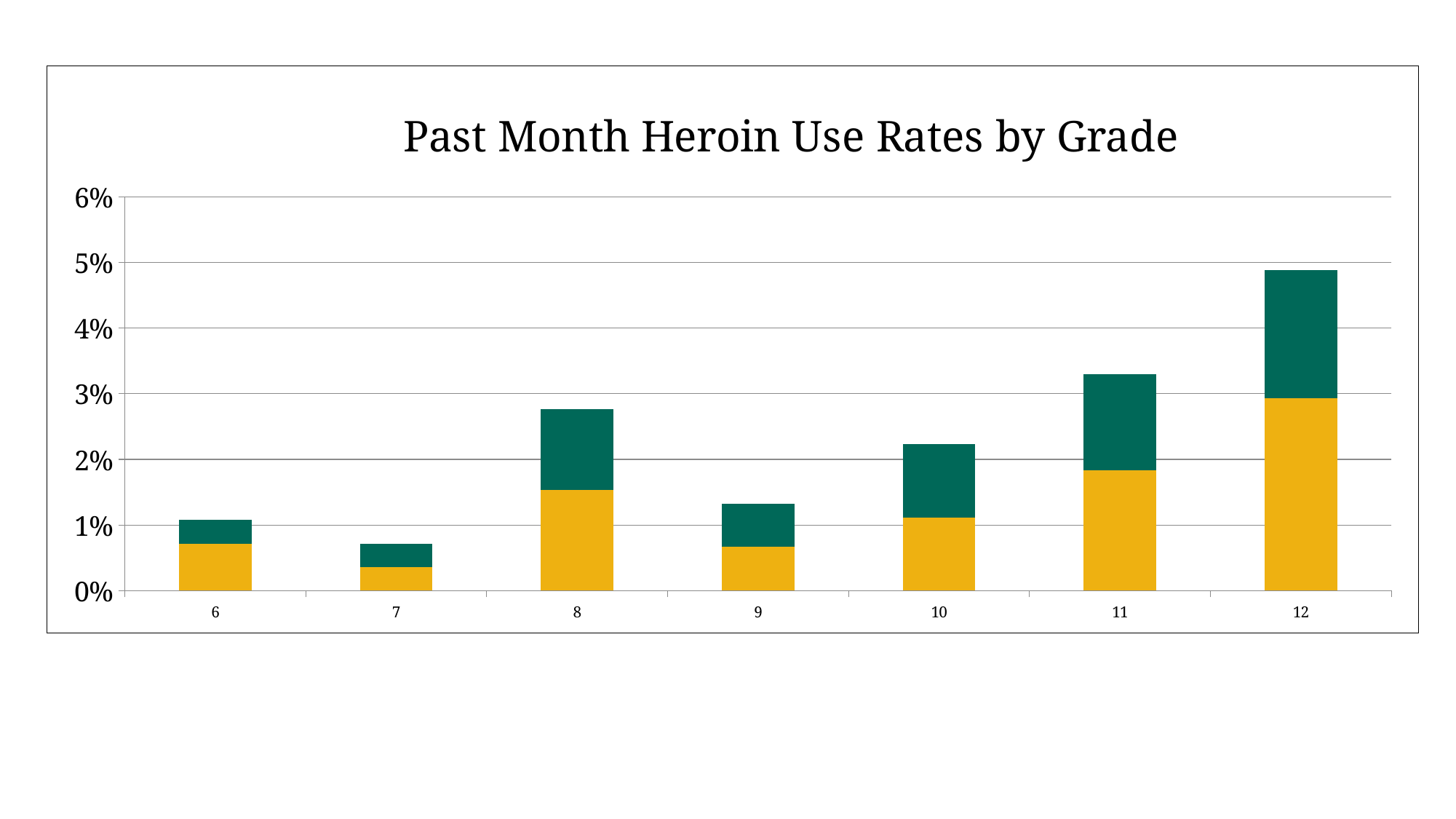
What is the title of the chart? Past Month Heroin Use Rates by Grade Which has the taller stacked bar, grade 8 or grade 9? Grade 8 Which grade has the tallest stacked bar? 12 Is the total bar height for grade 8 greater or less than 2%? greater What kind of chart is shown on the slide? Stacked bar chart How many grades are shown on the x axis of the chart? 7 Do the total bar heights rise or fall from grade 9 through grade 12? Rise Which grade has the shortest stacked bar? 7 Is the total bar height for grade 11 greater or less than 3%? greater Is the total bar height for grade 12 greater or less than 4%? greater Which has the taller stacked bar, grade 10 or grade 11? Grade 11